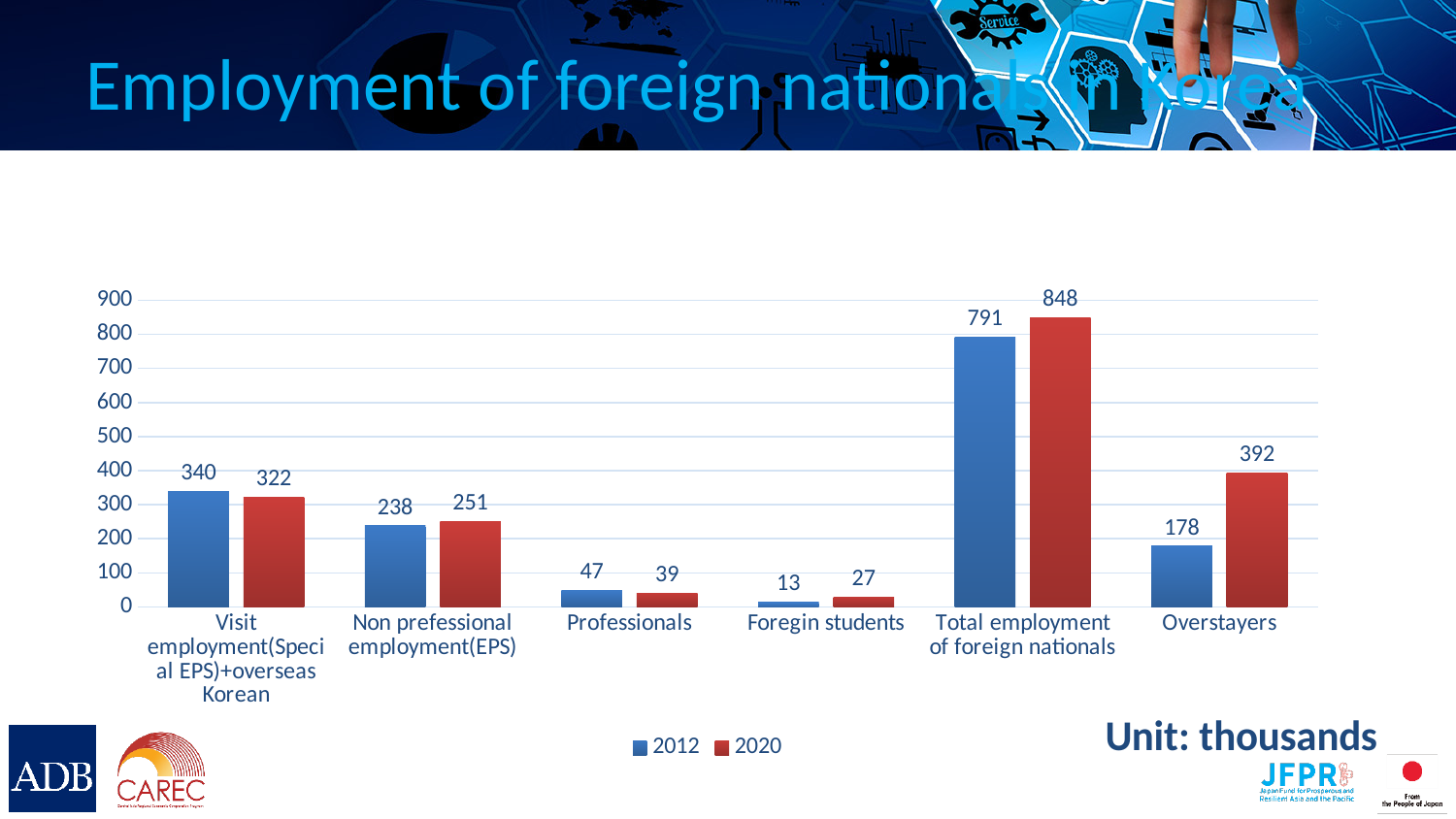
Which category has the lowest 2012 value? Foregin students What unit is stated for the values in the chart? thousands What kind of chart is shown on the slide? Bar chart Which category has the highest 2020 value? Total employment of foreign nationals How many categories are shown on the x axis? 6 Is the 2020 value for Total employment of foreign nationals greater or less than 800? greater How many series does the legend list? 2 Which is larger for Non prefessional employment(EPS): the 2012 value or the 2020 value? 2020 What is the 2012 value for Professionals? 47 What is the 2020 value for Overstayers? 392 What is the 2012 value for Total employment of foreign nationals? 791 What is the difference between the 2020 and 2012 values for Overstayers? 214